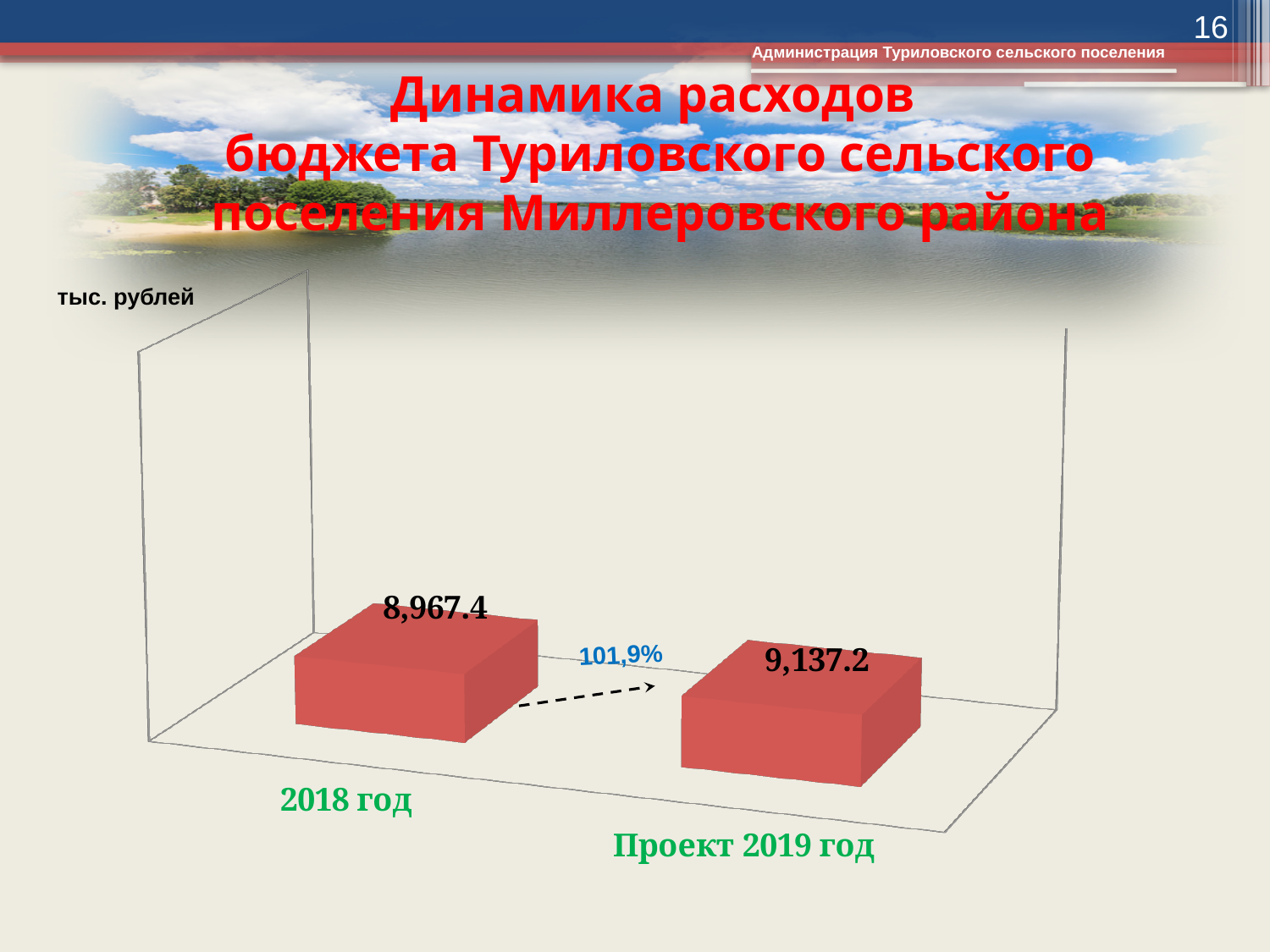
Do the values rise or fall from 2018 год to Проект 2019 год? Rise What percentage is shown on the arrow between the two bars? 101,9% What is the difference between the values for Проект 2019 год and 2018 год? 169.8 What unit of measurement is indicated for the chart values? тыс. рублей What is the value for 2018 год? 8,967.4 Which category has the highest value? Проект 2019 год What is the value for Проект 2019 год? 9,137.2 Which category has the lowest value? 2018 год How many categories are shown in the chart? 2 What kind of chart is shown on the slide? Bar chart Which is larger, the value for 2018 год or the value for Проект 2019 год? Проект 2019 год